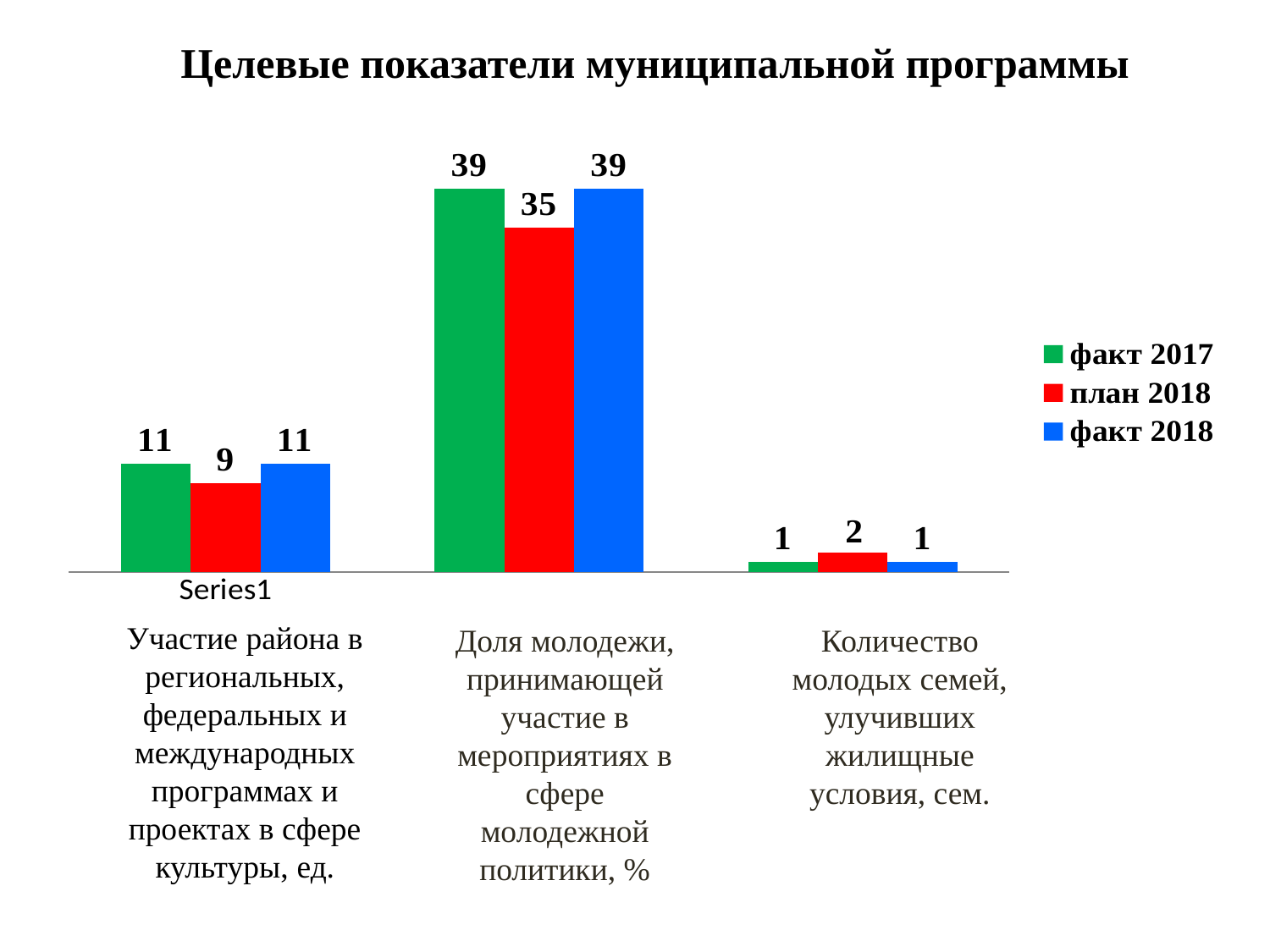
Which indicator has the lowest план 2018 value? Количество молодых семей, улучивших жилищные условия, сем. What is the difference between факт 2017 and план 2018 for 'Участие района в региональных, федеральных и международных программах и проектах в сфере культуры, ед.'? 2 Which indicator has the highest факт 2018 value? Доля молодежи, принимающей участие в мероприятиях в сфере молодежной политики, % What colour represents план 2018 in the chart? Red What kind of chart is shown on the slide? Bar chart What is the difference between факт 2018 and план 2018 for 'Доля молодежи, принимающей участие в мероприятиях в сфере молодежной политики, %'? 4 What is the value of план 2018 for 'Количество молодых семей, улучивших жилищные условия, сем.'? 2 What is the value of план 2018 for 'Доля молодежи, принимающей участие в мероприятиях в сфере молодежной политики, %'? 35 For 'Количество молодых семей, улучивших жилищные условия, сем.', which is larger: план 2018 or факт 2018? план 2018 How many series does the legend list? 3 What is the value of факт 2017 for 'Участие района в региональных, федеральных и международных программах и проектах в сфере культуры, ед.'? 11 What is the value of факт 2018 for 'Доля молодежи, принимающей участие в мероприятиях в сфере молодежной политики, %'? 39